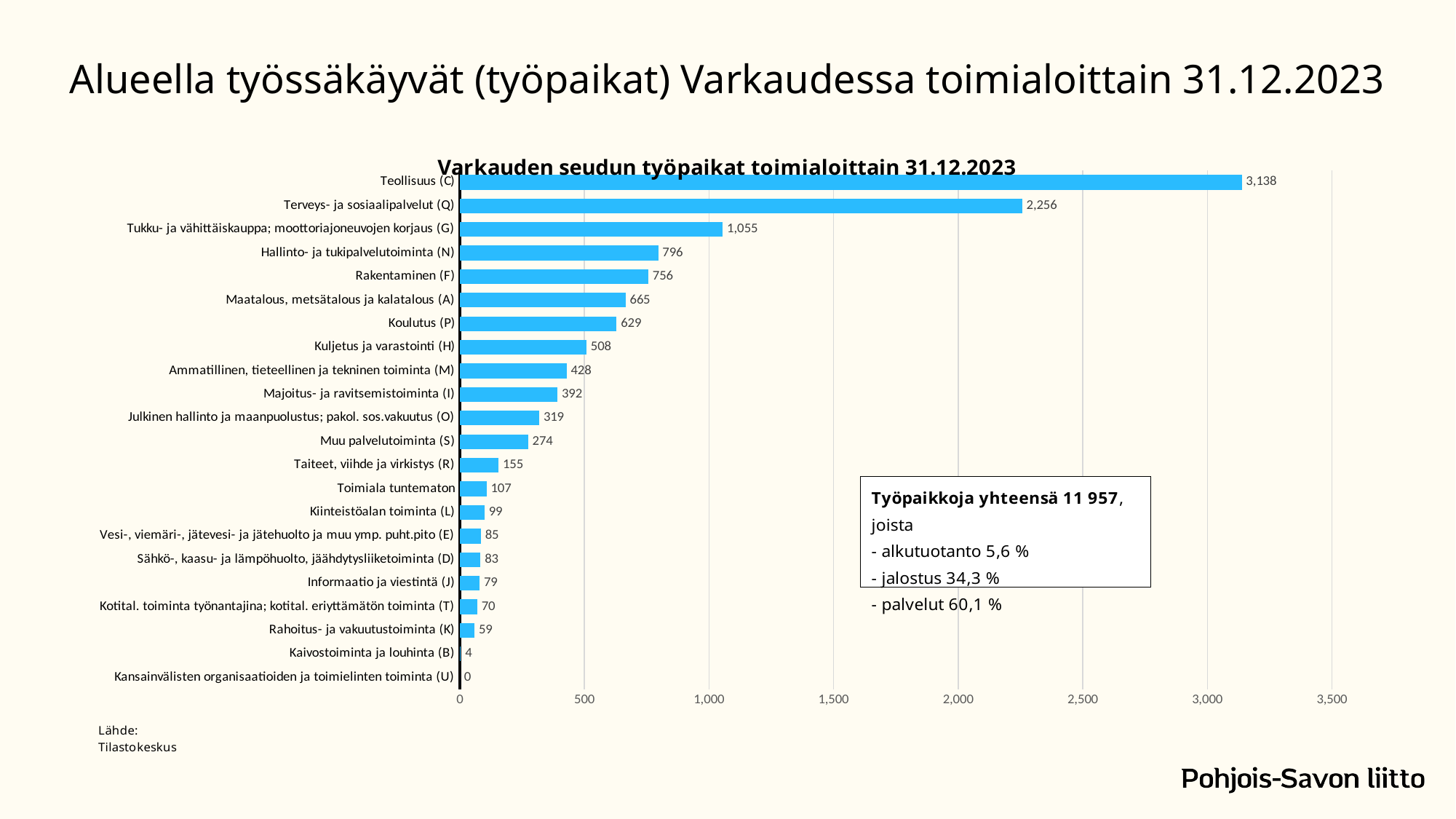
What kind of chart is shown on the slide? bar chart What is the value for Rahoitus- ja vakuutustoiminta (K)? 59 Which category has the lowest value? Kansainvälisten organisaatioiden ja toimielinten toiminta (U) What is the value for Koulutus (P)? 629 Is the value for Tukku- ja vähittäiskauppa; moottoriajoneuvojen korjaus (G) greater or less than 1,000? greater Which category has the highest value? Teollisuus (C) What is the difference between Rakentaminen (F) and Maatalous, metsätalous ja kalatalous (A)? 91 Which is larger, Kuljetus ja varastointi (H) or Majoitus- ja ravitsemistoiminta (I)? Kuljetus ja varastointi (H) How many categories are shown in the chart? 22 What is the value for Teollisuus (C)? 3,138 What is the difference between Teollisuus (C) and Terveys- ja sosiaalipalvelut (Q)? 882 What is the title of the chart? Varkauden seudun työpaikat toimialoittain 31.12.2023